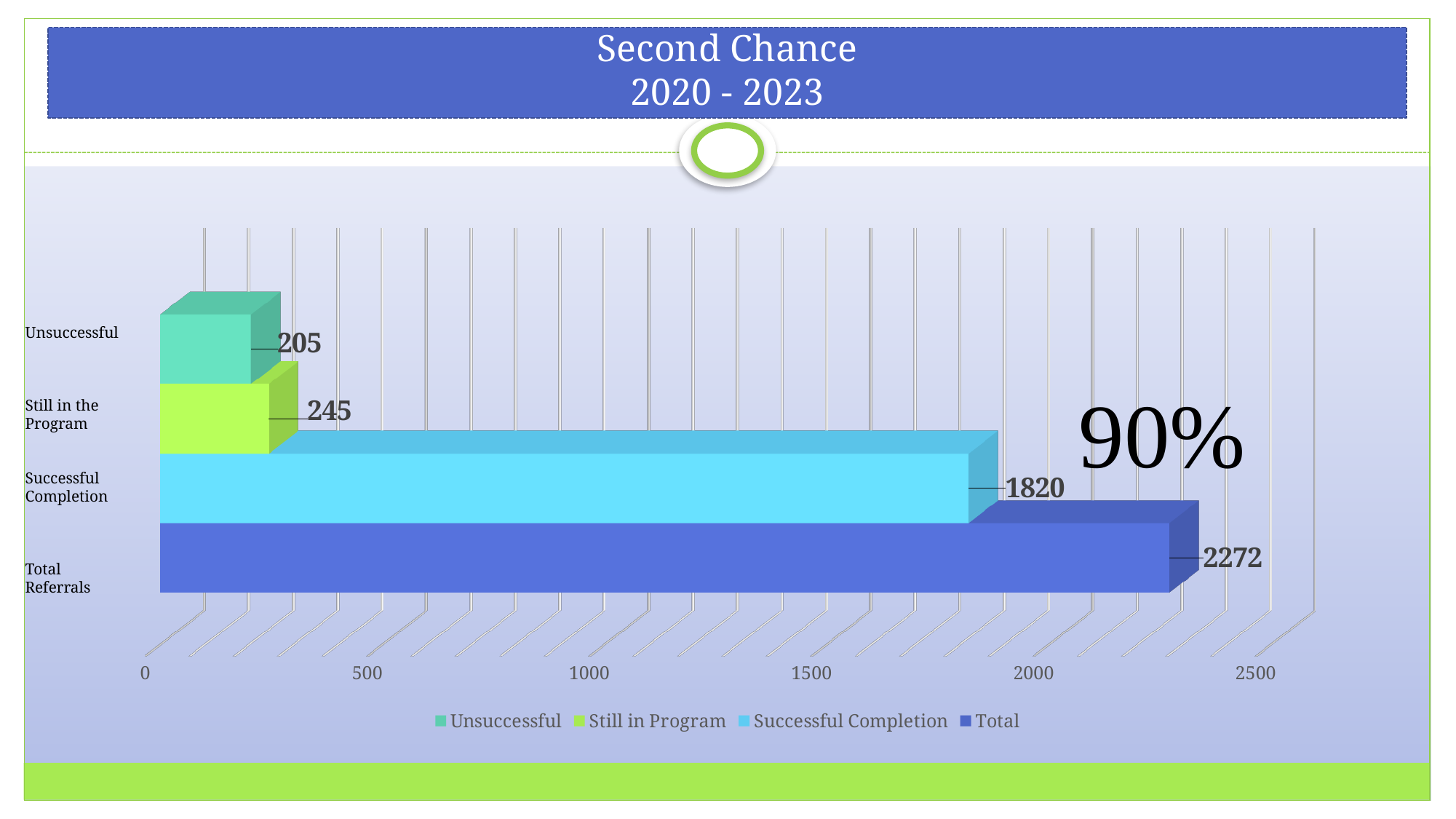
What is the difference between Still in the Program and Unsuccessful? 40 What is the value for Unsuccessful? 205 What is the value for Still in the Program? 245 What kind of chart is shown on the slide? Bar chart What is the value for Total Referrals? 2272 What is the value for Successful Completion? 1820 What is the difference between Total Referrals and Successful Completion? 452 Which category has the highest value? Total Referrals Which category has the lowest value? Unsuccessful Which is larger, Still in the Program or Unsuccessful? Still in the Program How many categories are shown in the chart? 4 How many entries does the legend list? 4